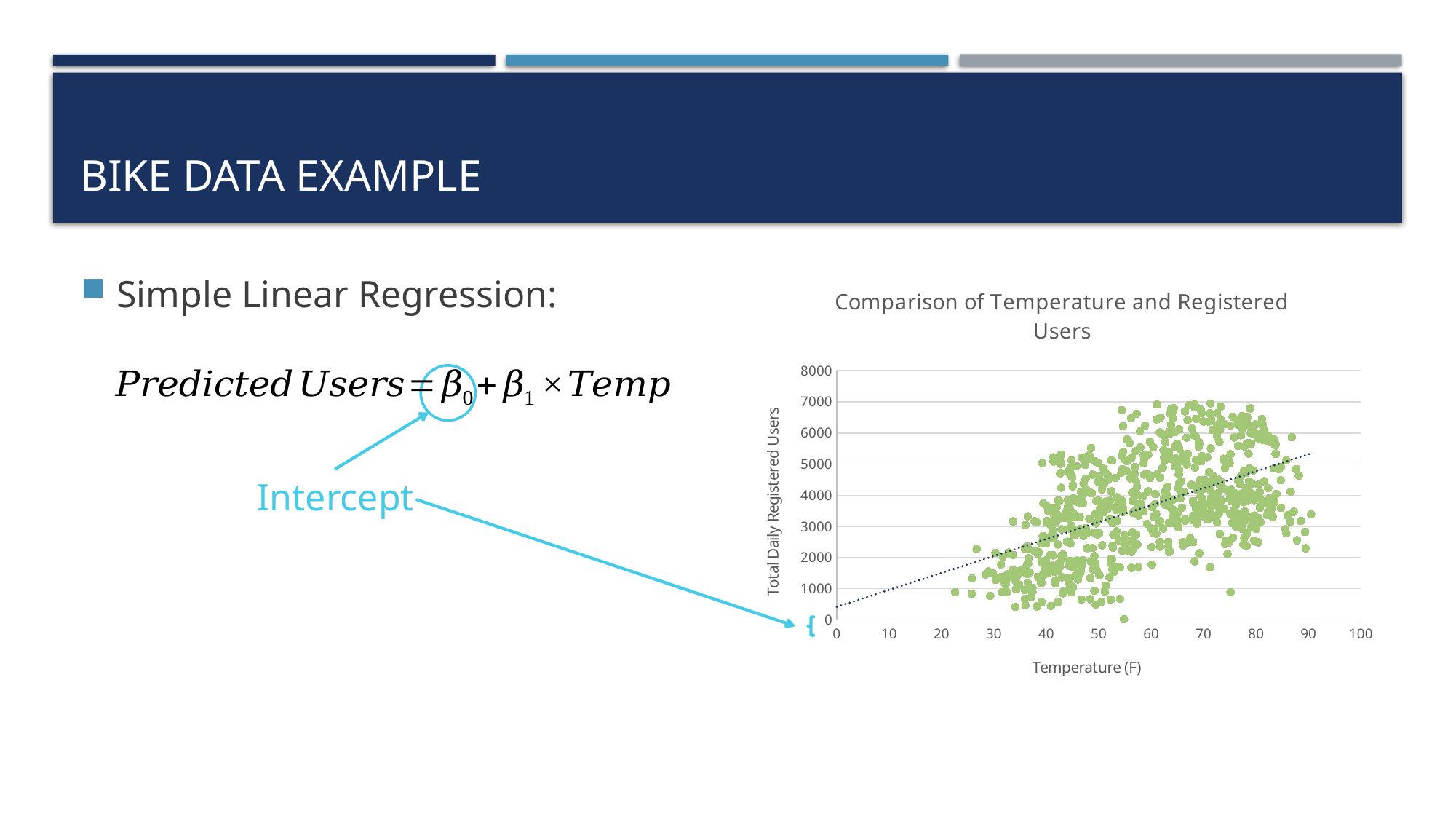
Is the value of the dotted trend line at a temperature of 0 greater or less than 1000? less Is the value of the dotted trend line at a temperature of 90 greater or less than 4000? greater Is the lowest temperature of any plotted point greater or less than 30? less What is the highest value shown on the x axis of the chart? 100 What is the highest value shown on the y axis of the chart? 8000 What is the title of the chart? Comparison of Temperature and Registered Users As temperature increases along the x axis, do the registered users generally rise or fall? rise What kind of chart is shown on the slide? scatter chart What is the label of the x axis of the chart? Temperature (F)